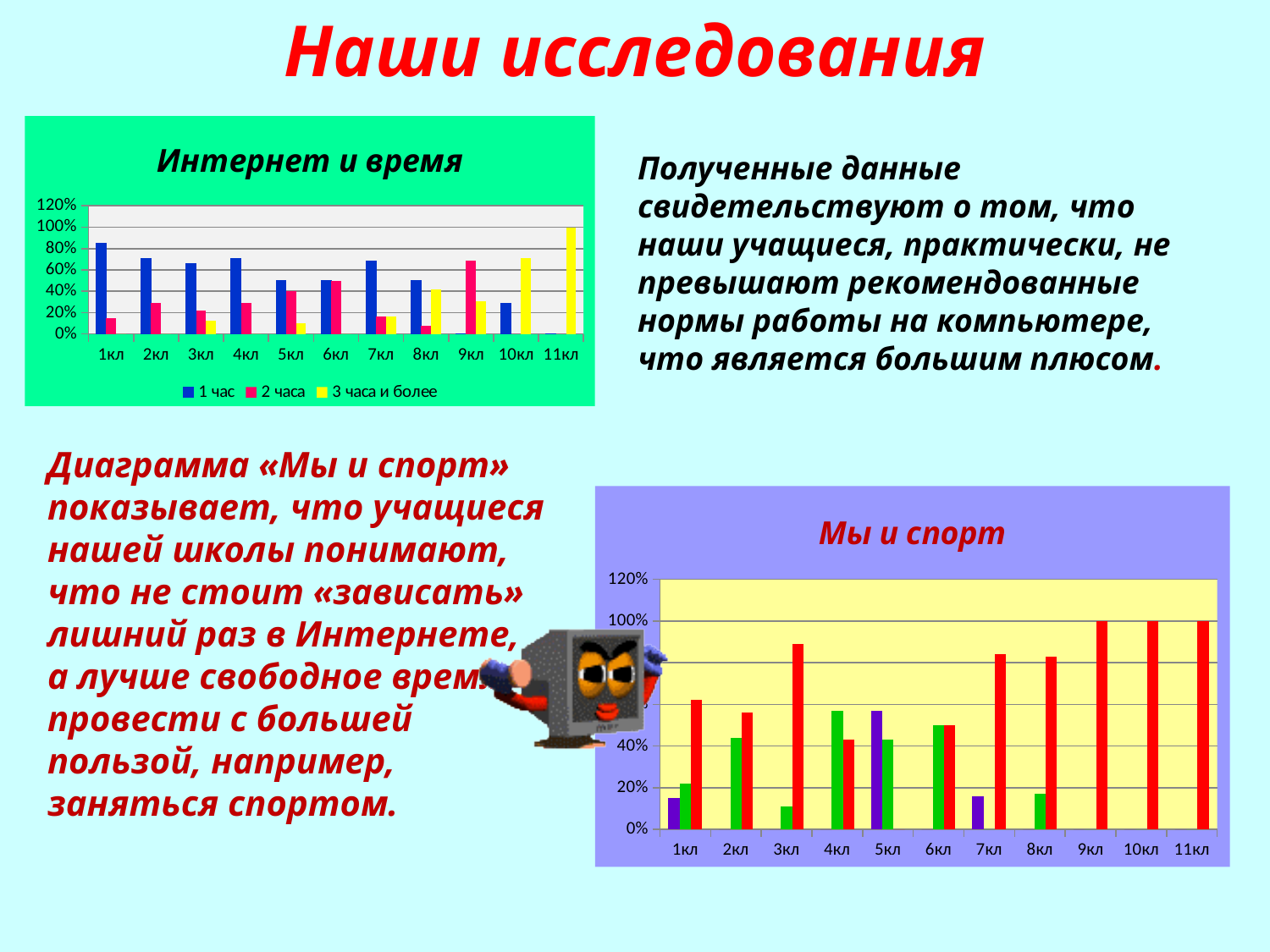
What kind of chart is "Мы и спорт"? bar chart In the "Интернет и время" chart, which colour represents the "2 часа" series? pink In the "Интернет и время" chart, which class has the highest value for "3 часа и более"? 11кл In the "Интернет и время" chart, how many classes are shown on the x axis? 11 In the "Интернет и время" chart, which is larger for 1кл: "1 час" or "2 часа"? 1 час In the "Мы и спорт" chart, what is the value of the red bar for 9кл? 100% In the "Интернет и время" chart, is the value of "1 час" for 1кл greater or less than 60%? greater What kind of chart is "Интернет и время"? bar chart In the "Интернет и время" chart, what is the value of "3 часа и более" for 11кл? 100% In the "Мы и спорт" chart, how many classes are shown on the x axis? 11 In the "Интернет и время" chart, how many series does the legend list? 3 In the "Мы и спорт" chart, is the value of the purple bar for 7кл greater or less than 20%? less